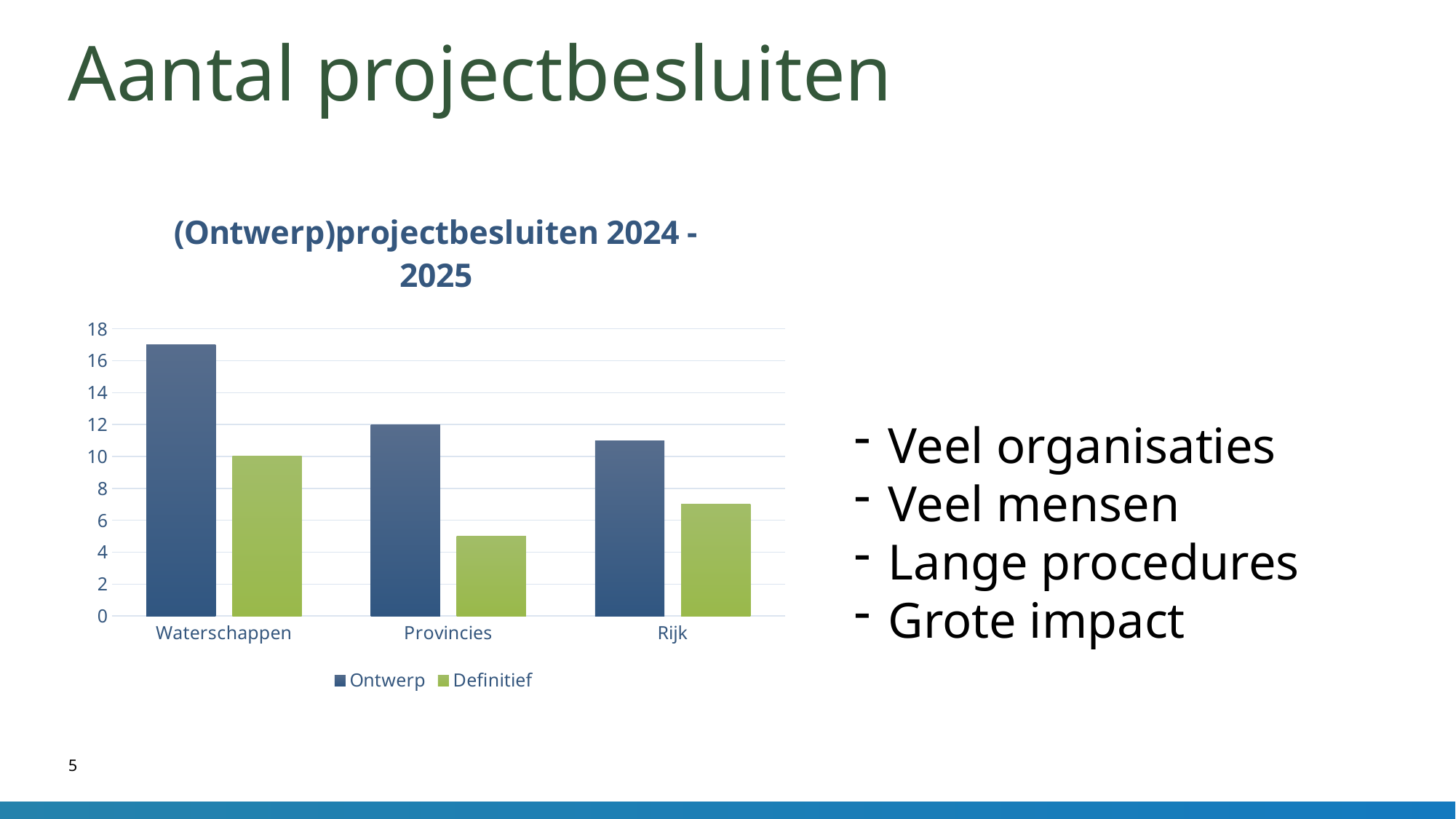
What is the difference between the Ontwerp value for Provincies and the Definitief value for Waterschappen? 2 How many series does the chart's legend list? 2 Which category has the lowest Definitief value? Provincies What is the Definitief value for Waterschappen? 10 Is the Ontwerp value for Waterschappen greater or less than 16? greater Is the Definitief value for Provincies greater or less than 6? less For Rijk, which is larger: the Ontwerp value or the Definitief value? Ontwerp Which category has the highest Ontwerp value? Waterschappen What is the title of the chart? (Ontwerp)projectbesluiten 2024 - 2025 What is the Ontwerp value for Provincies? 12 What kind of chart is shown on the slide? bar chart How many categories are shown on the x axis of the chart? 3